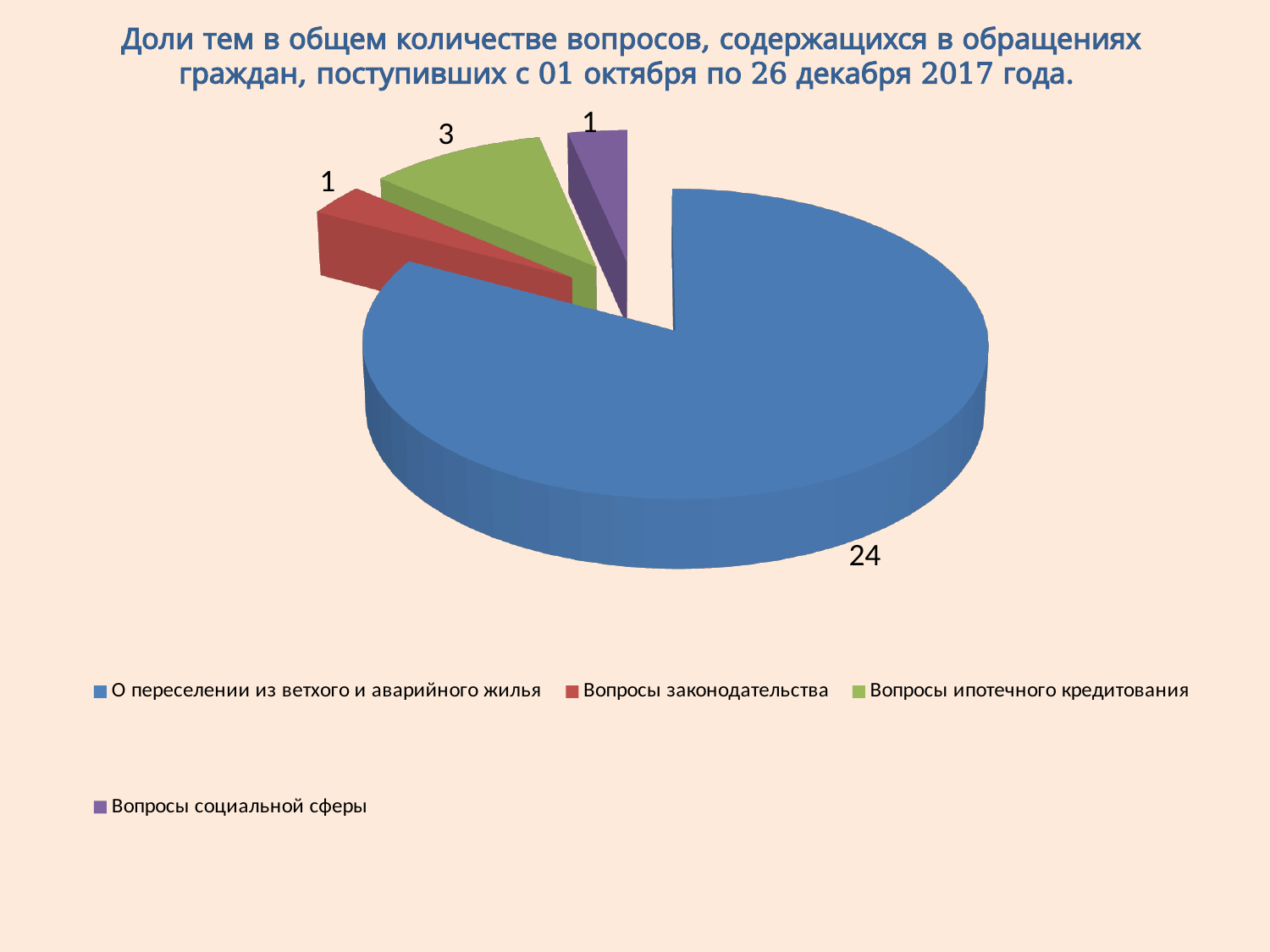
What type of chart is shown on the slide? Pie chart What fraction of the total does the "О переселении из ветхого и аварийного жилья" slice represent? 24 out of 29 What is the value for "О переселении из ветхого и аварийного жилья"? 24 What is the total of all slice values in the pie chart? 29 What colour is the slice for "Вопросы социальной сферы"? Purple How many categories (slices) does the pie chart have? 4 What is the value for "Вопросы ипотечного кредитования"? 3 Which is larger: the value for "Вопросы ипотечного кредитования" or the value for "Вопросы законодательства"? Вопросы ипотечного кредитования Which category has the largest slice of the pie? О переселении из ветхого и аварийного жилья What is the value for "Вопросы законодательства"? 1 What is the value for "Вопросы социальной сферы"? 1 What is the difference between the values for "О переселении из ветхого и аварийного жилья" and "Вопросы ипотечного кредитования"? 21